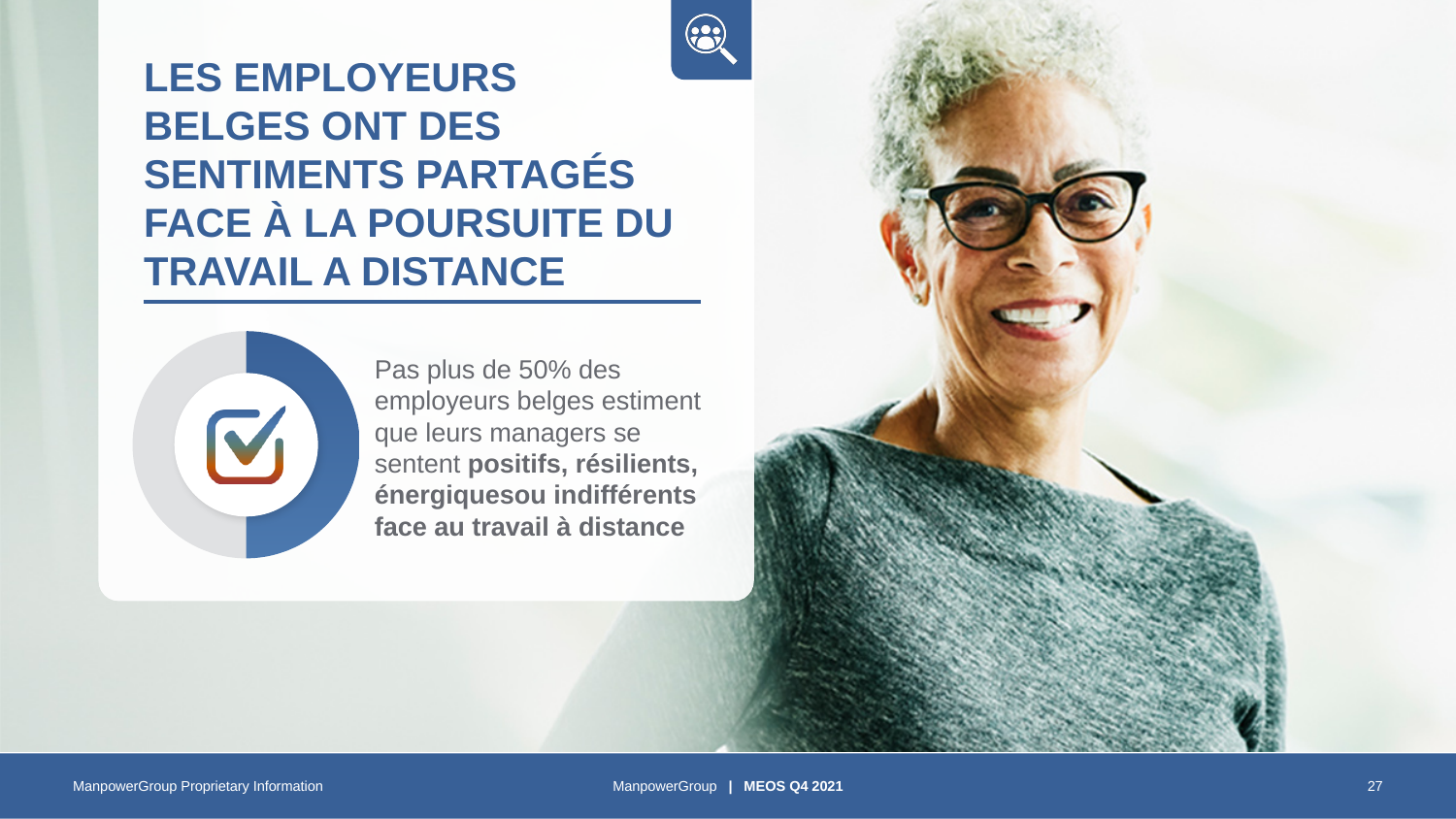
What share of the donut chart is filled in blue? 50% What icon is shown in the centre of the donut chart? A checkmark What colour is the filled half of the donut chart? Blue Is the blue slice of the donut chart larger or smaller than the grey slice? Equal How many slices does the donut chart on the slide have? 2 What kind of chart is shown on the slide next to the text about Belgian employers? Donut (pie) chart According to the slide, what percentage of Belgian employers feel their managers are positive, resilient, energetic or indifferent about remote work? No more than 50% ("Pas plus de 50%")